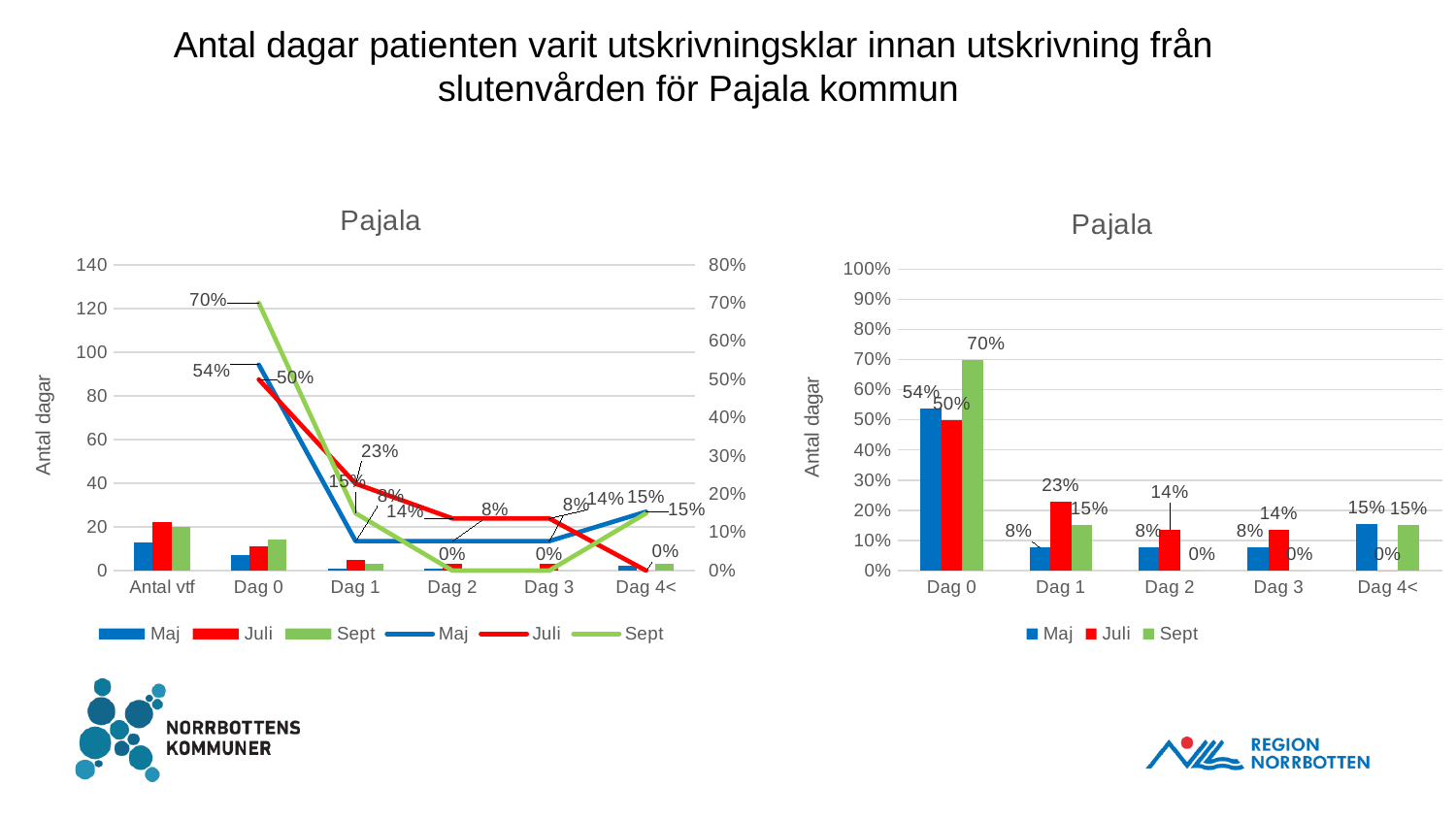
On the right chart, what is the value for Juli at Dag 1? 23% On the right chart, which series has the highest value at Dag 0? Sept On the right chart, how many series does the legend list? 3 On the right chart, which series has the lowest value at Dag 2? Sept What kind of chart is the right chart? Bar chart On the left chart, is the Juli bar for Antal vtf greater or less than 20? greater On the right chart, what is the value for Maj at Dag 4<? 15% On the right chart, which is larger at Dag 1: Maj or Juli? Juli On the right chart, what is the difference between Sept and Juli at Dag 0? 20% On the left chart, how many categories are shown on the x axis? 6 On the right chart, what is the value for Sept at Dag 0? 70% On the right chart, how many categories are shown on the x axis? 5